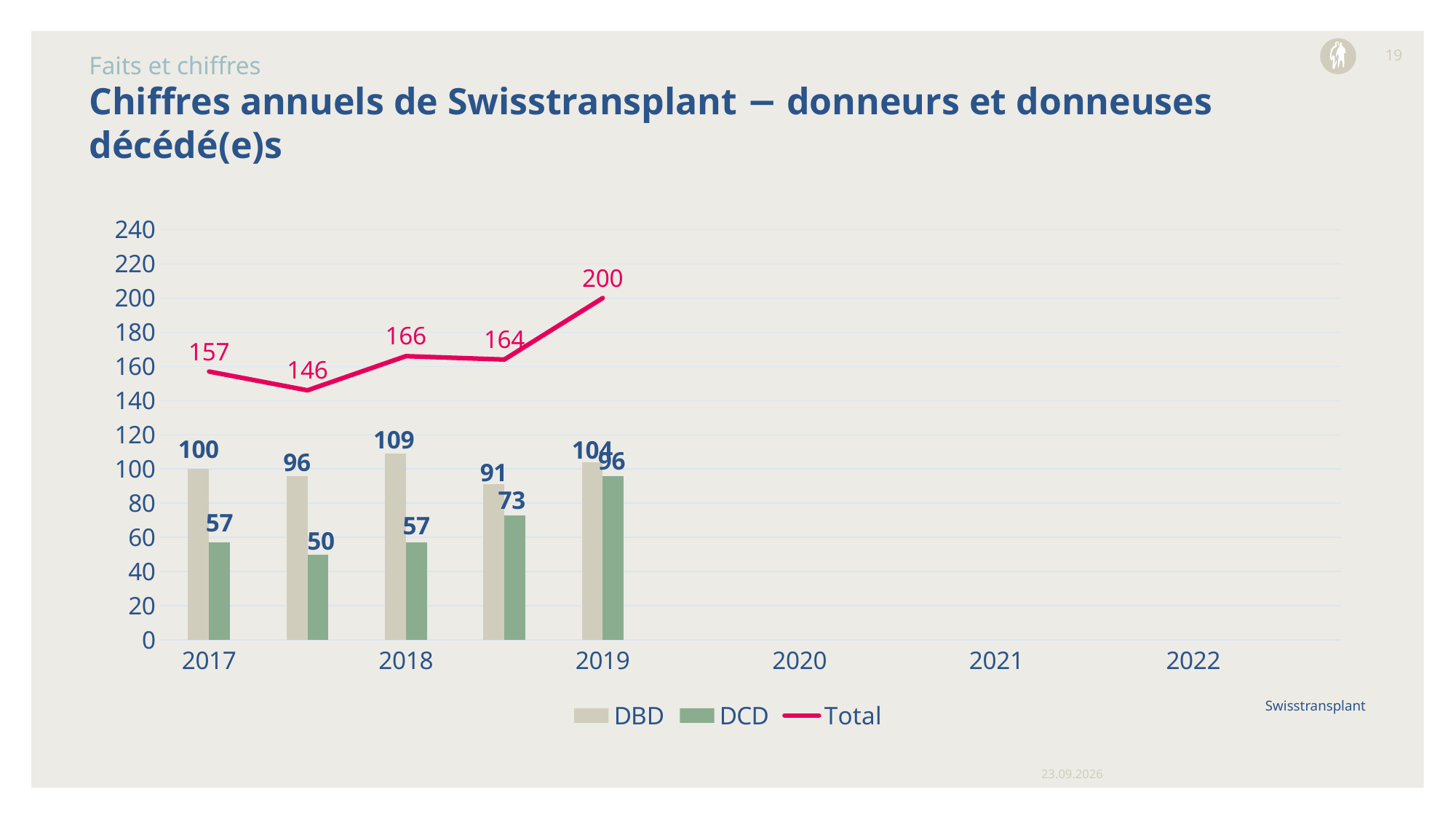
How many data points are plotted on the Total line? 5 What is the DBD value for the group of bars at 2017? 100 What is the Total value for the second group of bars from the left? 146 What is the difference between the DBD and DCD values for the group of bars at 2018? 52 Which group of bars has the highest DCD value? The group at 2019 (96) What is the DCD value for the group of bars at 2019? 96 What is the lowest value on the Total line? 146 What is the highest value on the Total line? 200 What kind of chart is shown on the slide? A bar chart combined with a line How many series does the legend list? 3 Which is larger, the DBD value at 2017 or the DBD value at 2019? 2019 (104) Does the Total line rise or fall from the fourth group of bars to the fifth group? Rises